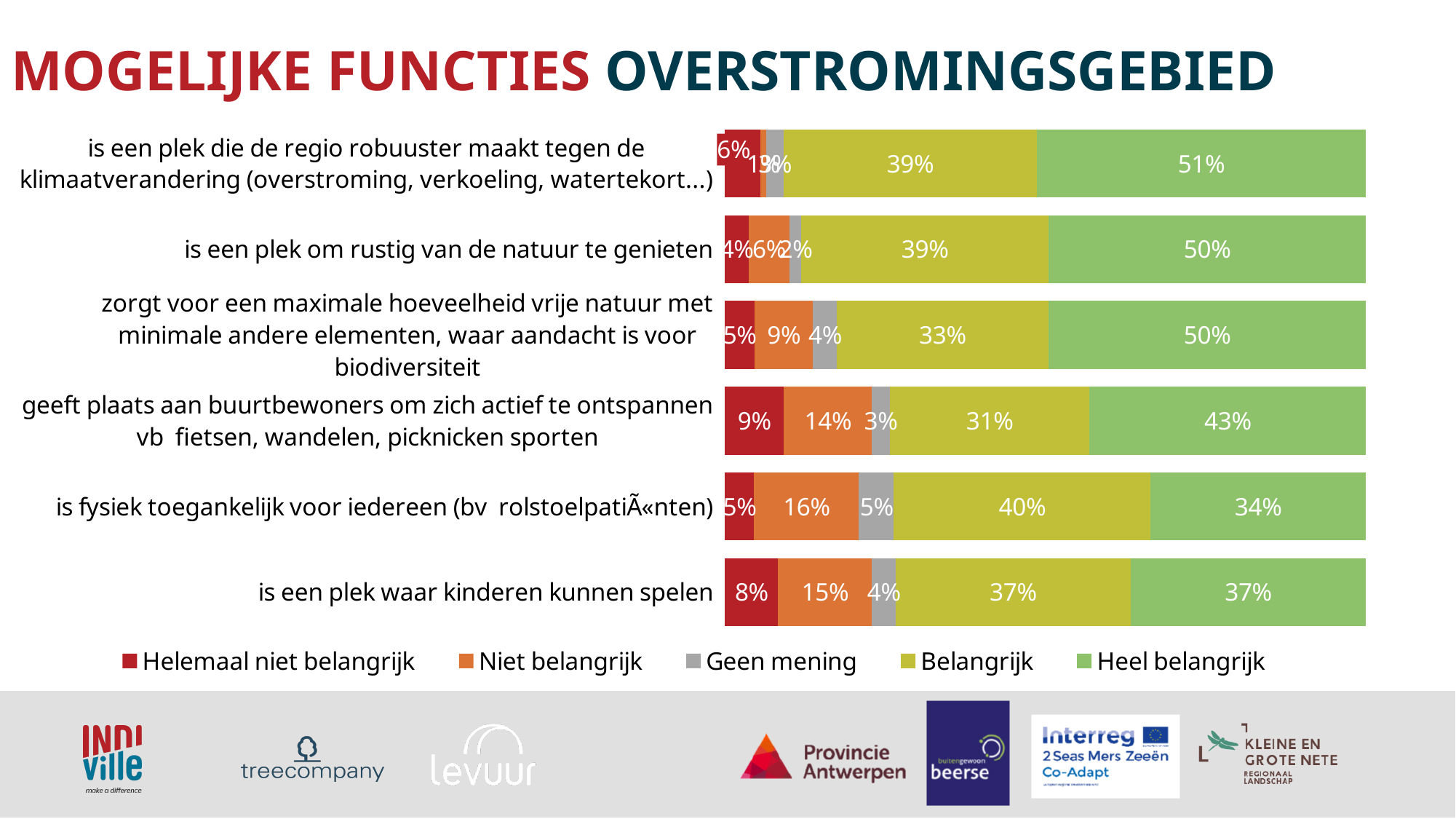
What is the Helemaal niet belangrijk value for 'geeft plaats aan buurtbewoners om zich actief te ontspannen'? 9% What is the difference between the Belangrijk and Heel belangrijk values for 'is fysiek toegankelijk voor iedereen'? 6% Which legend entry is shown in grey? Geen mening Which is larger: the Niet belangrijk value for 'is een plek waar kinderen kunnen spelen' or for 'geeft plaats aan buurtbewoners om zich actief te ontspannen'? is een plek waar kinderen kunnen spelen Which function has the highest Heel belangrijk share? is een plek die de regio robuuster maakt tegen de klimaatverandering What percentage of respondents rated 'is een plek waar kinderen kunnen spelen' as Heel belangrijk? 37% Which function has the lowest Heel belangrijk share? is fysiek toegankelijk voor iedereen What is the Belangrijk value for 'zorgt voor een maximale hoeveelheid vrije natuur met minimale andere elementen, waar aandacht is voor biodiversiteit'? 33% How many functions (categories) are shown in the chart? 6 How many series does the legend list? 5 What is the Niet belangrijk value for 'is fysiek toegankelijk voor iedereen'? 16% What kind of chart is shown on the slide? Stacked bar chart